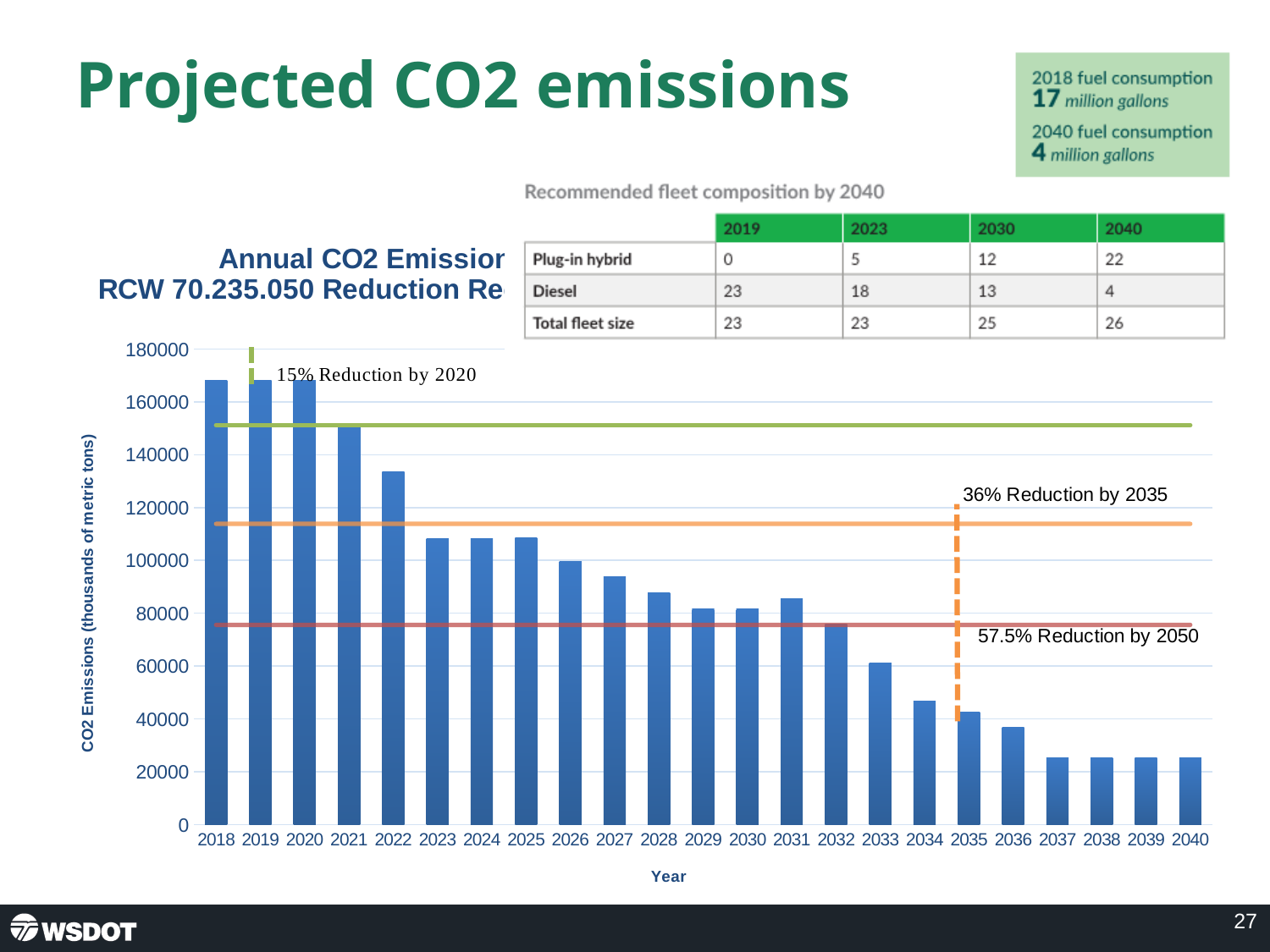
What reduction percentage is annotated for 2035 on the CO2 emissions chart? 36% Is the CO2 emissions value for 2033 greater or less than 80000? less Is the CO2 emissions value for 2040 greater or less than 40000? less Which year has the larger CO2 emissions value, 2022 or 2033? 2022 What is the label on the x axis of the CO2 emissions chart? Year Is the CO2 emissions value for 2026 greater or less than 80000? greater What kind of chart is used to show the annual CO2 emissions? bar chart How many years are plotted on the x axis of the CO2 emissions chart? 23 Do the CO2 emissions values generally rise or fall from 2018 to 2040? fall Which year has the larger CO2 emissions value, 2035 or 2028? 2028